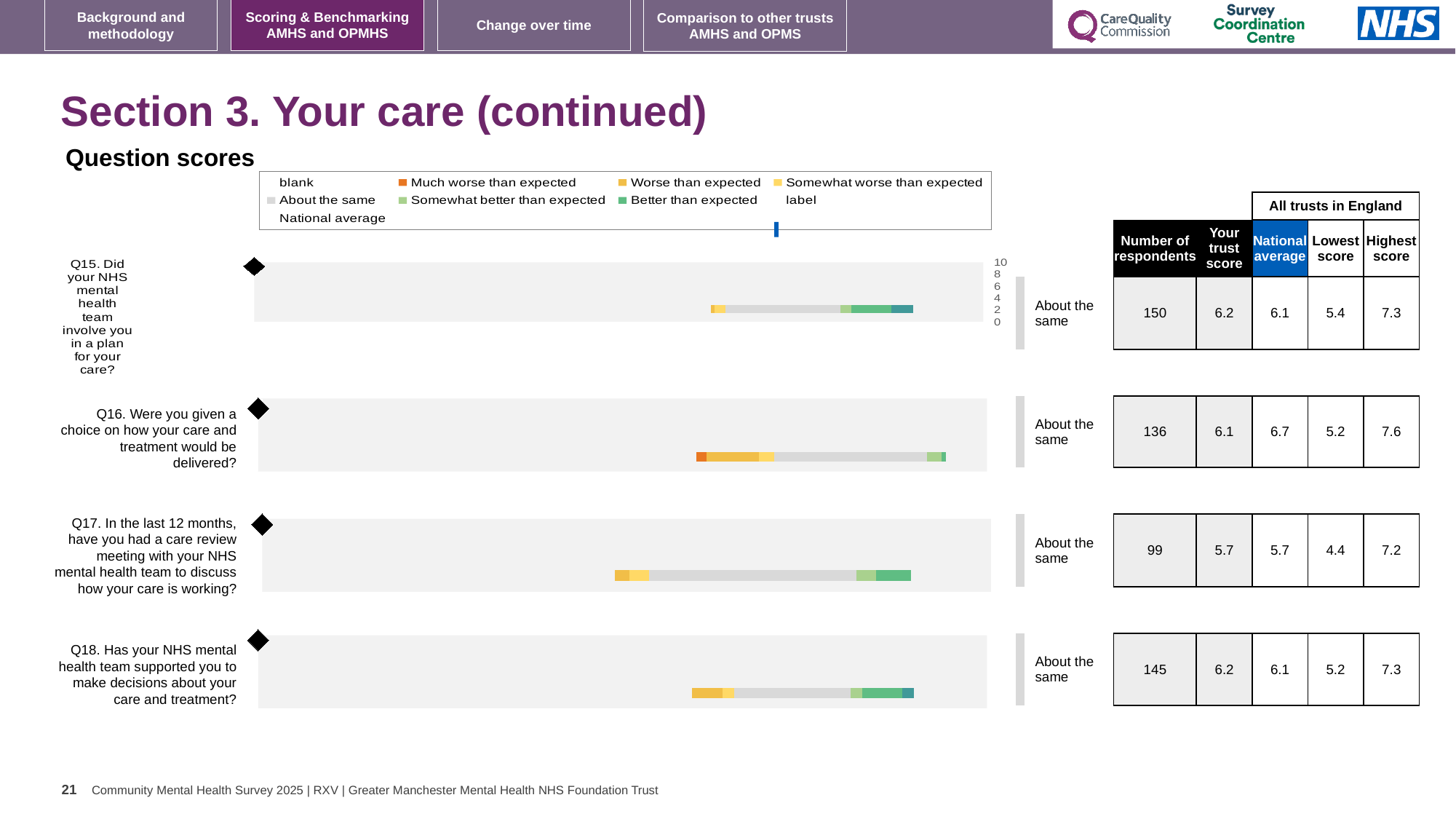
Which question has the largest number of respondents? Q15 What kind of chart is used to show the question scores for Q15 to Q18? Bar chart In the table next to the charts, how many respondents are listed for Q15? 150 What is the national average shown for Q17? 5.7 What comparison label is shown next to the bar for Q18? About the same How many survey questions (Q15 to Q18) have a bar plotted on the slide? 4 Which question has the lowest 'Your trust score'? Q17 What is the lowest score across all trusts in England shown for Q17? 4.4 For Q16, what is the difference between the highest score and the lowest score across all trusts in England? 2.4 What is the highest score across all trusts in England shown for Q18? 7.3 For Q16, which is larger: the trust score or the national average? National average What is the 'Your trust score' value shown for Q16? 6.1